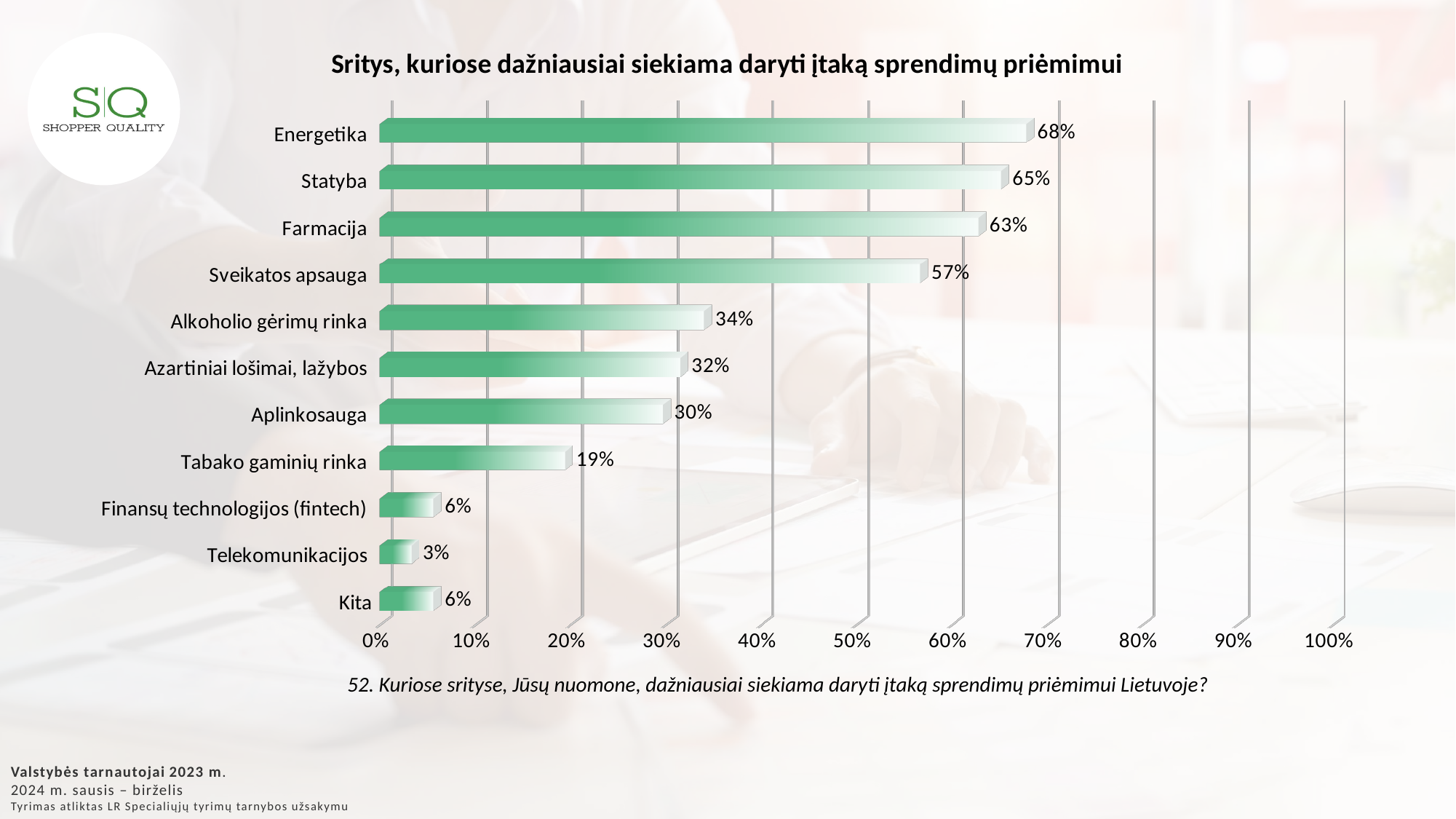
What kind of chart is shown on the slide? bar chart Which is larger, the value for Alkoholio gėrimų rinka or the value for Azartiniai lošimai, lažybos? Alkoholio gėrimų rinka What is the value for Energetika? 68% What is the difference between the values for Energetika and Statyba? 3% What is the difference between the values for Farmacija and Aplinkosauga? 33% Is the value for Farmacija greater or less than 50%? greater How many categories are shown in the chart? 11 Which category has the lowest value? Telekomunikacijos What is the title of the chart? Sritys, kuriose dažniausiai siekiama daryti įtaką sprendimų priėmimui Which category has the highest value? Energetika What is the value for Sveikatos apsauga? 57% What is the value for Tabako gaminių rinka? 19%